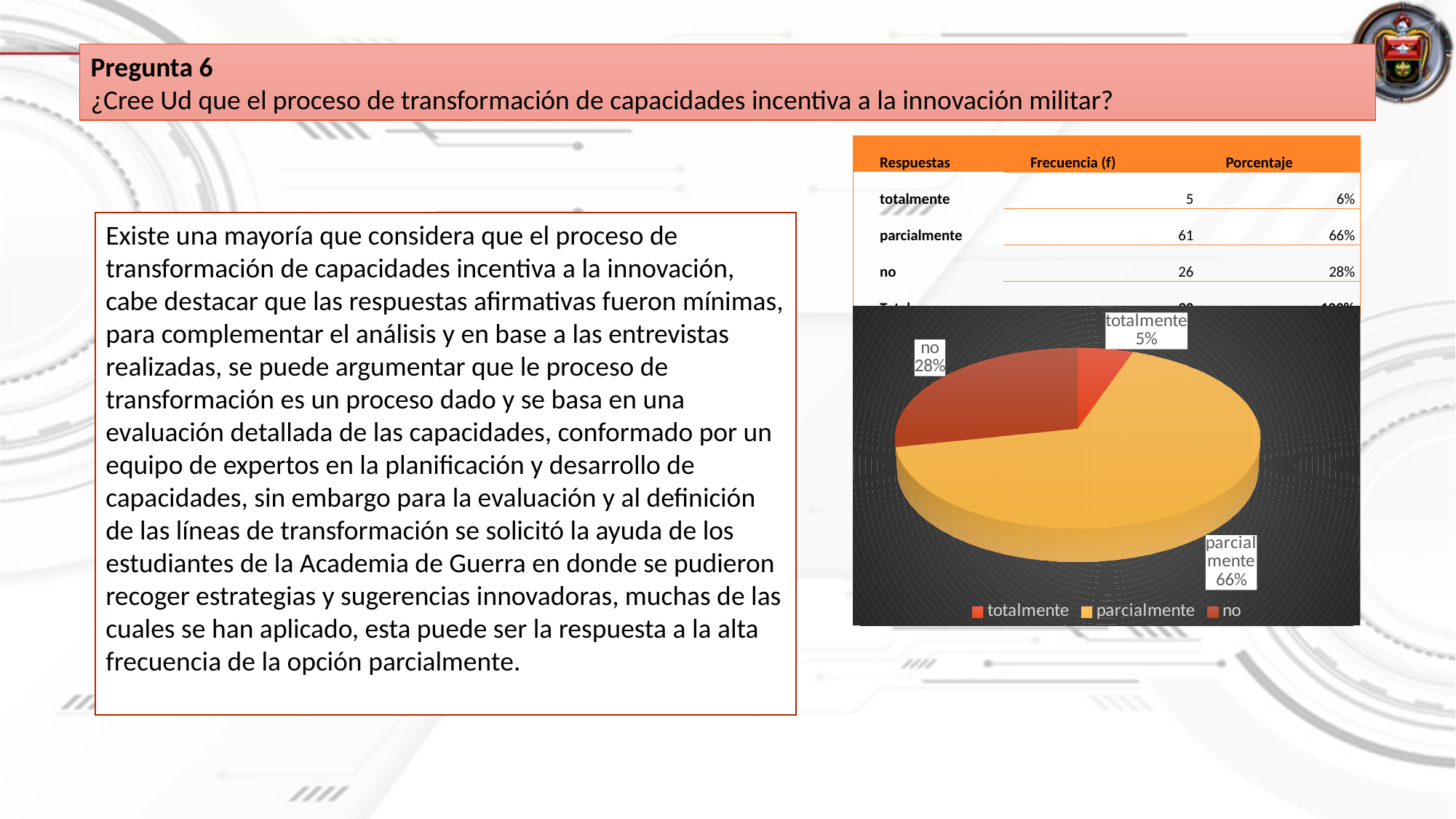
Which slice of the pie chart is the smallest? totalmente What colour is the 'parcialmente' slice in the pie chart? yellow/orange Which slice of the pie chart is the largest? parcialmente What is the difference in percentage points between the 'parcialmente' slice and the 'no' slice in the pie chart? 38% What share of the pie chart does the 'parcialmente' slice represent? 66% What kind of chart is shown on the slide? pie chart What are the legend entries of the pie chart, in order? totalmente, parcialmente, no What share of the pie chart does the 'no' slice represent? 28% Which is larger in the pie chart, the 'no' slice or the 'totalmente' slice? no How many entries does the legend of the pie chart list? 3 How many slices does the pie chart have? 3 What share of the pie chart does the 'totalmente' slice represent? 5%